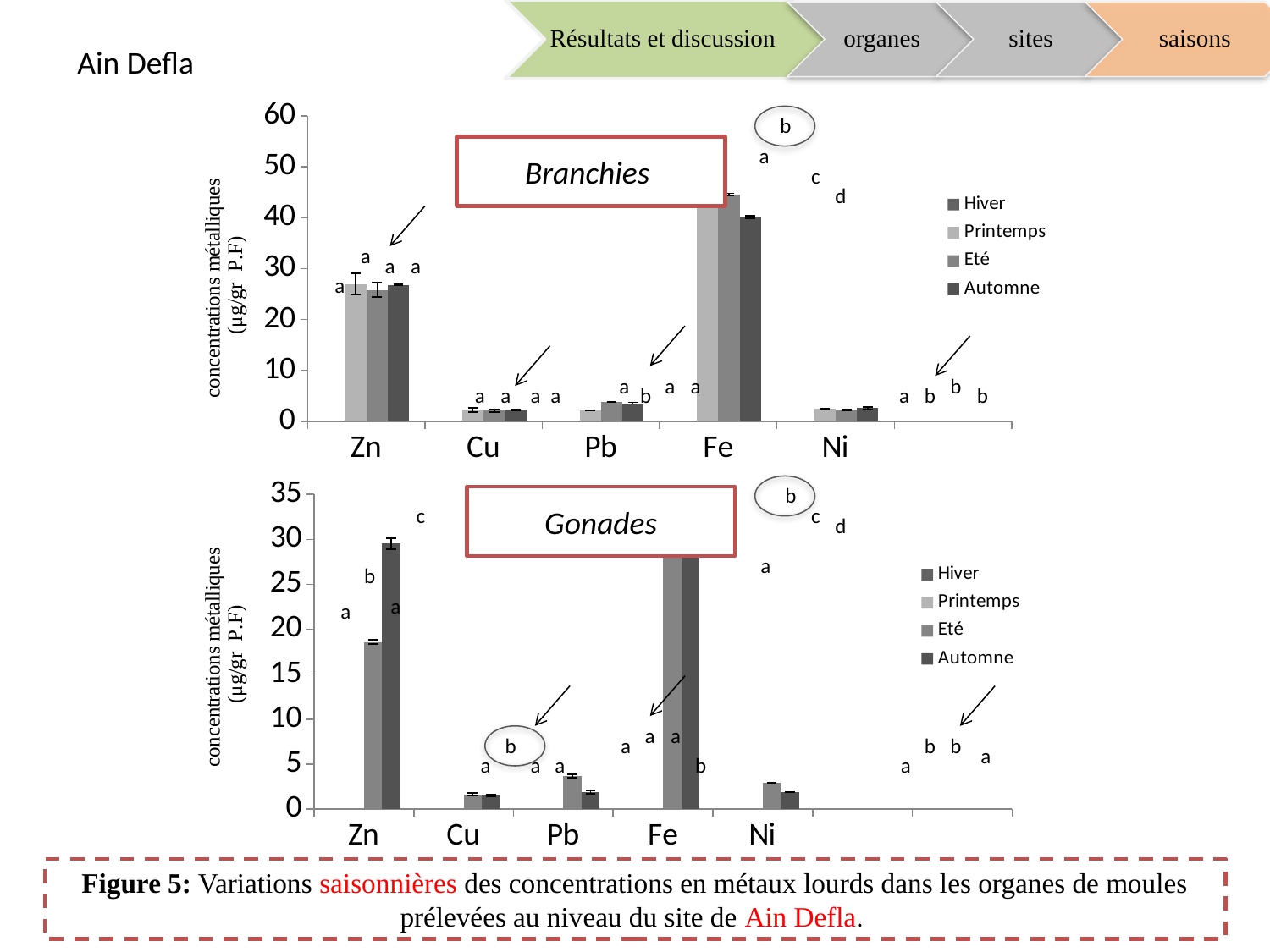
How many metal categories are shown on the x axis of the Gonades chart? 5 What kind of chart is the Branchies chart at the top of the slide? bar chart In the Branchies chart, is the Eté value for Fe greater or less than 40? greater In the Gonades chart, is the Eté value for Zn greater or less than 20? less In the Gonades chart, which is larger for Zn: the Eté value or the Automne value? Automne In the Branchies chart, is the Printemps value for Zn greater or less than 30? less In the Gonades chart, which is larger for Pb: the Eté value or the Automne value? Eté How many series does the legend of the Branchies chart list? 4 What are the four series listed in the legend of the Gonades chart? Hiver, Printemps, Eté, Automne In the Branchies chart, which is larger: the Fe values or the Zn values? Fe In the Branchies chart, which metal has the highest concentrations? Fe